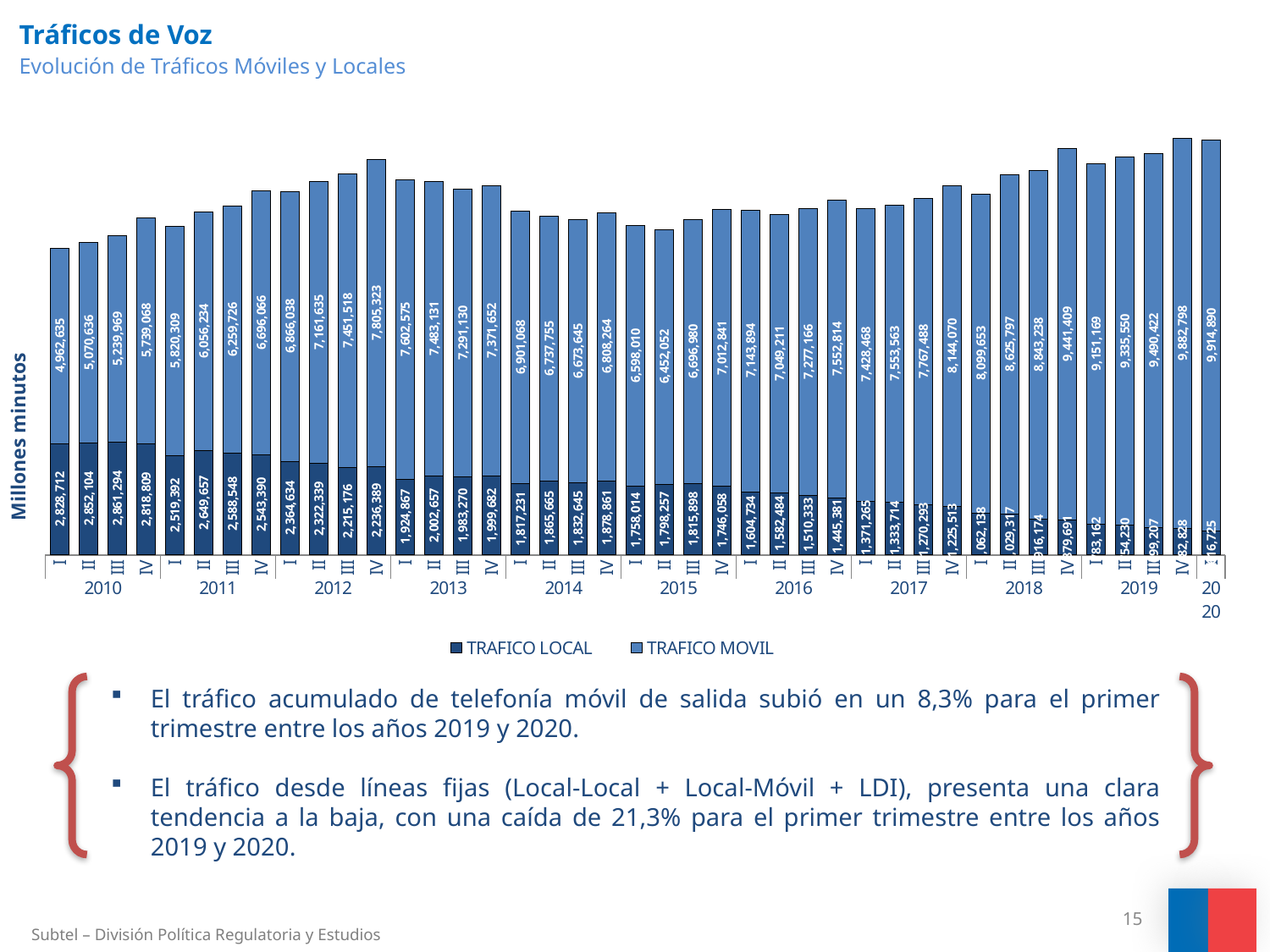
In which quarter is TRAFICO MOVIL lowest? I 2010 In which quarter is TRAFICO MOVIL highest? I 2020 What is the TRAFICO MOVIL value for quarter II of 2015? 6,452,052 How many series does the legend list? 2 What is the difference in TRAFICO MOVIL between quarter IV and quarter III of 2012? 353,805 What is the TRAFICO LOCAL value for quarter I of 2010? 2,828,712 Does TRAFICO LOCAL generally rise or fall from 2010 to 2020? Fall Which has the larger TRAFICO LOCAL value, quarter I of 2011 or quarter II of 2011? II 2011 What kind of chart is shown on the slide? Stacked bar chart What is the total of the stacked bar for quarter I of 2010 (TRAFICO LOCAL plus TRAFICO MOVIL)? 7,791,347 What is the TRAFICO MOVIL value for quarter I of 2020? 9,914,890 What is the label on the vertical axis of the chart? Millones minutos